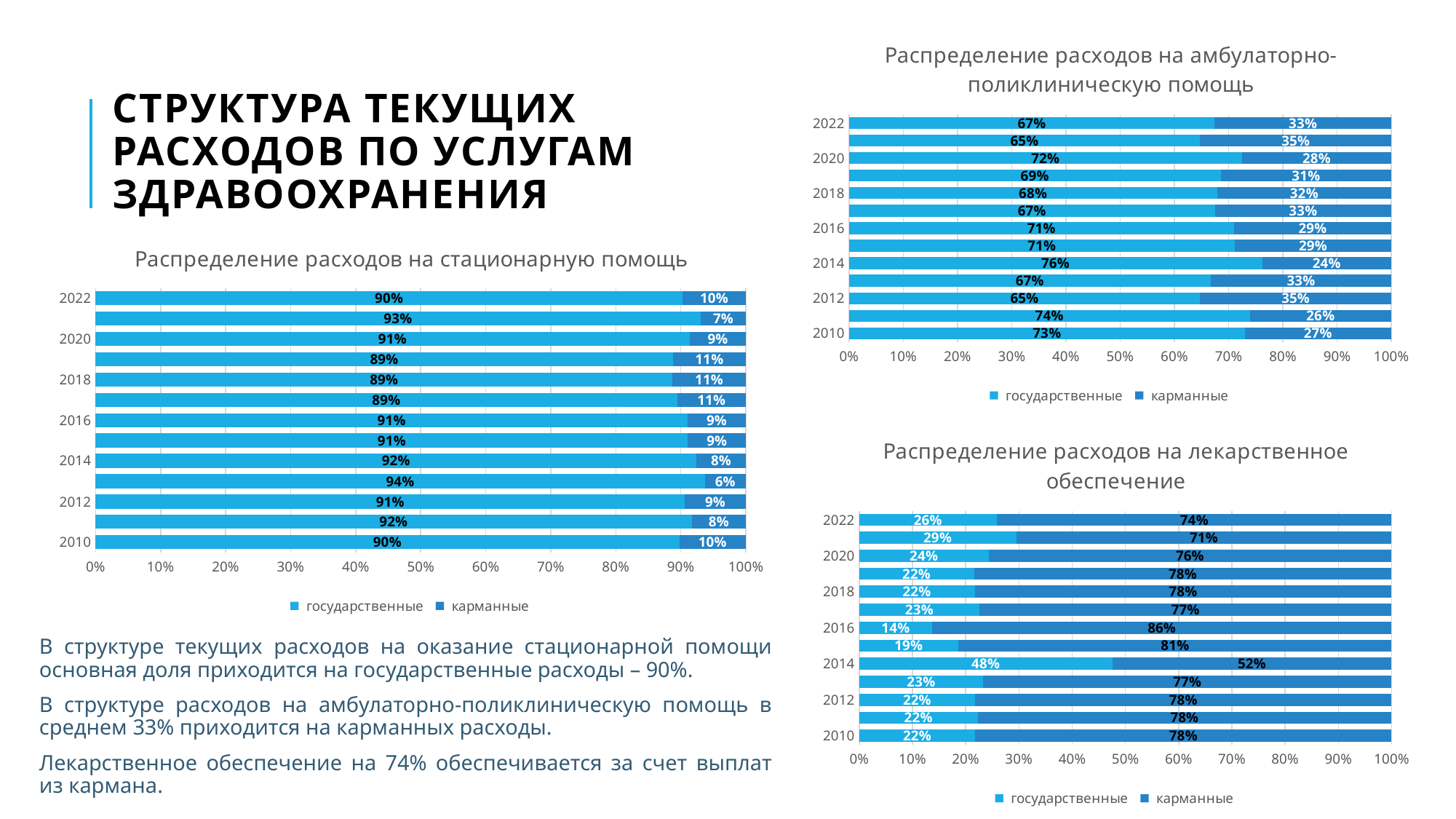
In the chart 'Распределение расходов на стационарную помощь', what is the value for карманные in 2018? 11% In the chart 'Распределение расходов на лекарственное обеспечение', which is larger: the карманные value in 2020 or in 2022? 2020 In the chart 'Распределение расходов на амбулаторно-поликлиническую помощь', what is the difference between the государственные value in 2014 and in 2022? 9% In the chart 'Распределение расходов на амбулаторно-поликлиническую помощь', what is the value for карманные in 2014? 24% How many years are plotted in the chart 'Распределение расходов на стационарную помощь'? 13 In the chart 'Распределение расходов на лекарственное обеспечение', which labelled year has the highest value for государственные? 2014 In the chart 'Распределение расходов на стационарную помощь', what is the value for государственные in 2022? 90% How many series does the legend of the chart 'Распределение расходов на амбулаторно-поликлиническую помощь' list? 2 In the chart 'Распределение расходов на лекарственное обеспечение', what is the value for карманные in 2016? 86% In the chart 'Распределение расходов на лекарственное обеспечение', which labelled year has the lowest value for государственные? 2016 What kind of chart is 'Распределение расходов на лекарственное обеспечение'? Stacked bar chart In the chart 'Распределение расходов на стационарную помощь', what is the total of the 2010 bar? 100%